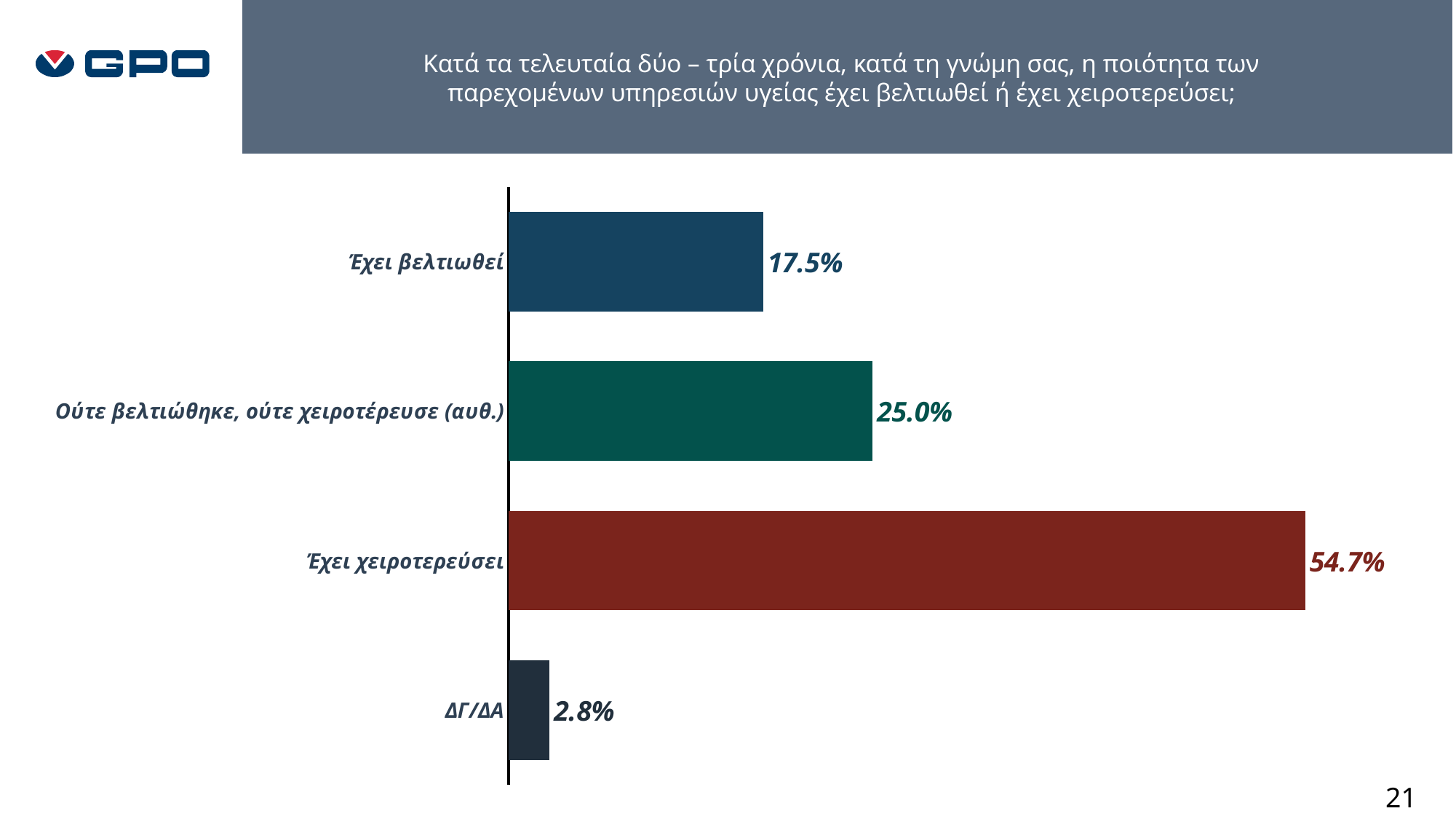
What is the value for Ούτε βελτιώθηκε, ούτε χειροτέρευσε (αυθ.)? 25.0% Which category has the lowest value? ΔΓ/ΔΑ What is the difference between the values for Ούτε βελτιώθηκε, ούτε χειροτέρευσε (αυθ.) and Έχει βελτιωθεί? 7.5% Which is larger, the value for Έχει βελτιωθεί or the value for Ούτε βελτιώθηκε, ούτε χειροτέρευσε (αυθ.)? Ούτε βελτιώθηκε, ούτε χειροτέρευσε (αυθ.) How many categories are shown in the chart? 4 What colour is the bar for Έχει χειροτερεύσει? Dark red What is the value for Έχει χειροτερεύσει? 54.7% What is the difference between the values for Έχει χειροτερεύσει and Έχει βελτιωθεί? 37.2% What is the value for ΔΓ/ΔΑ? 2.8% What is the value for Έχει βελτιωθεί? 17.5% What kind of chart is shown on the slide? Bar chart Which category has the highest value? Έχει χειροτερεύσει